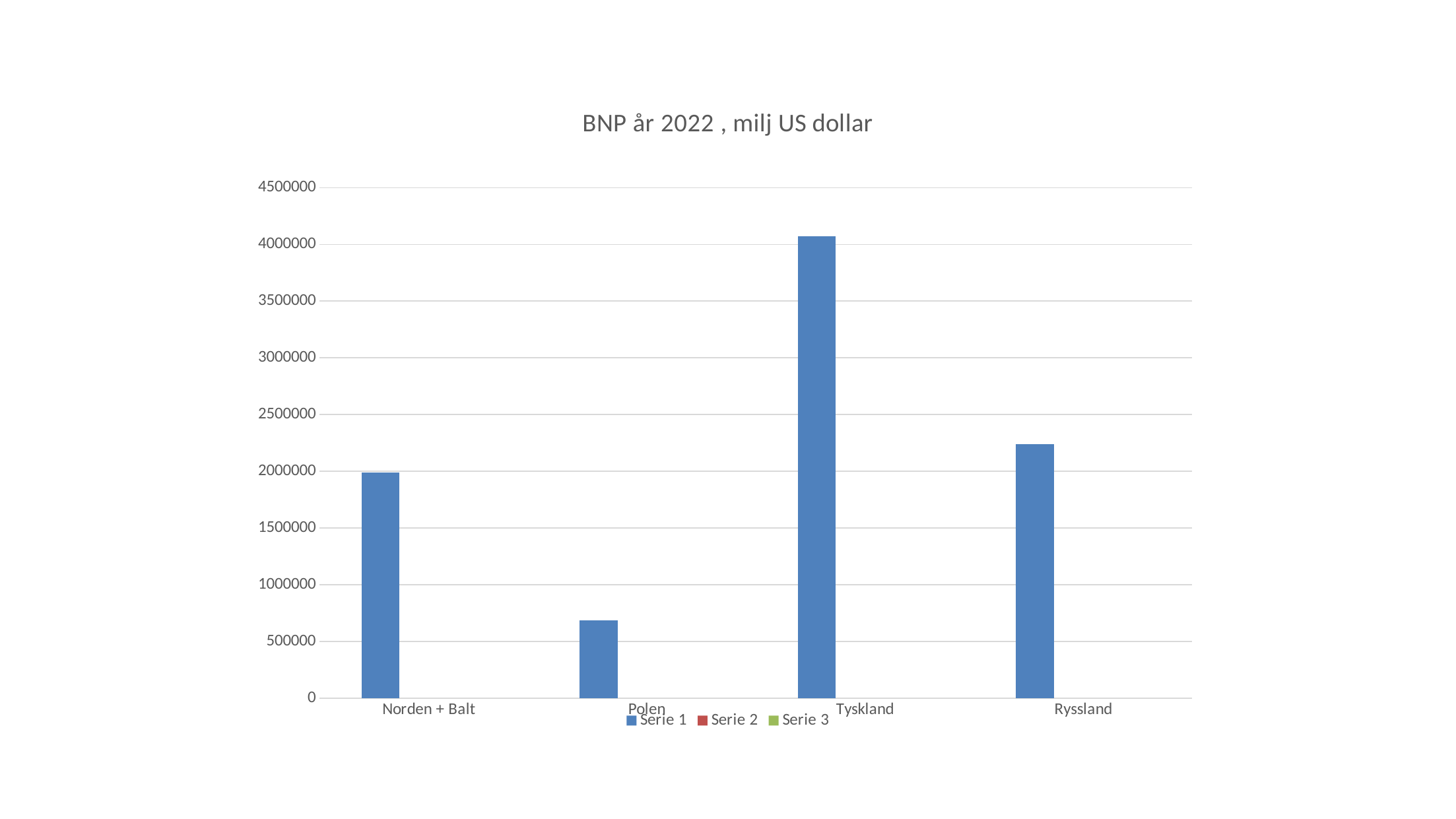
Is the value for Polen greater or less than 1000000? less How many series does the legend list? 3 Is the value for Ryssland greater or less than 2000000? greater What is the title of the chart? BNP år 2022 , milj US dollar Which category has the lowest value? Polen Is the value for Tyskland greater or less than 4000000? greater Which category has the highest value? Tyskland Which is larger, the value for Ryssland or the value for Norden + Balt? Ryssland How many categories are shown on the x axis? 4 What kind of chart is shown on the slide? bar chart Which is larger, the value for Polen or the value for Tyskland? Tyskland